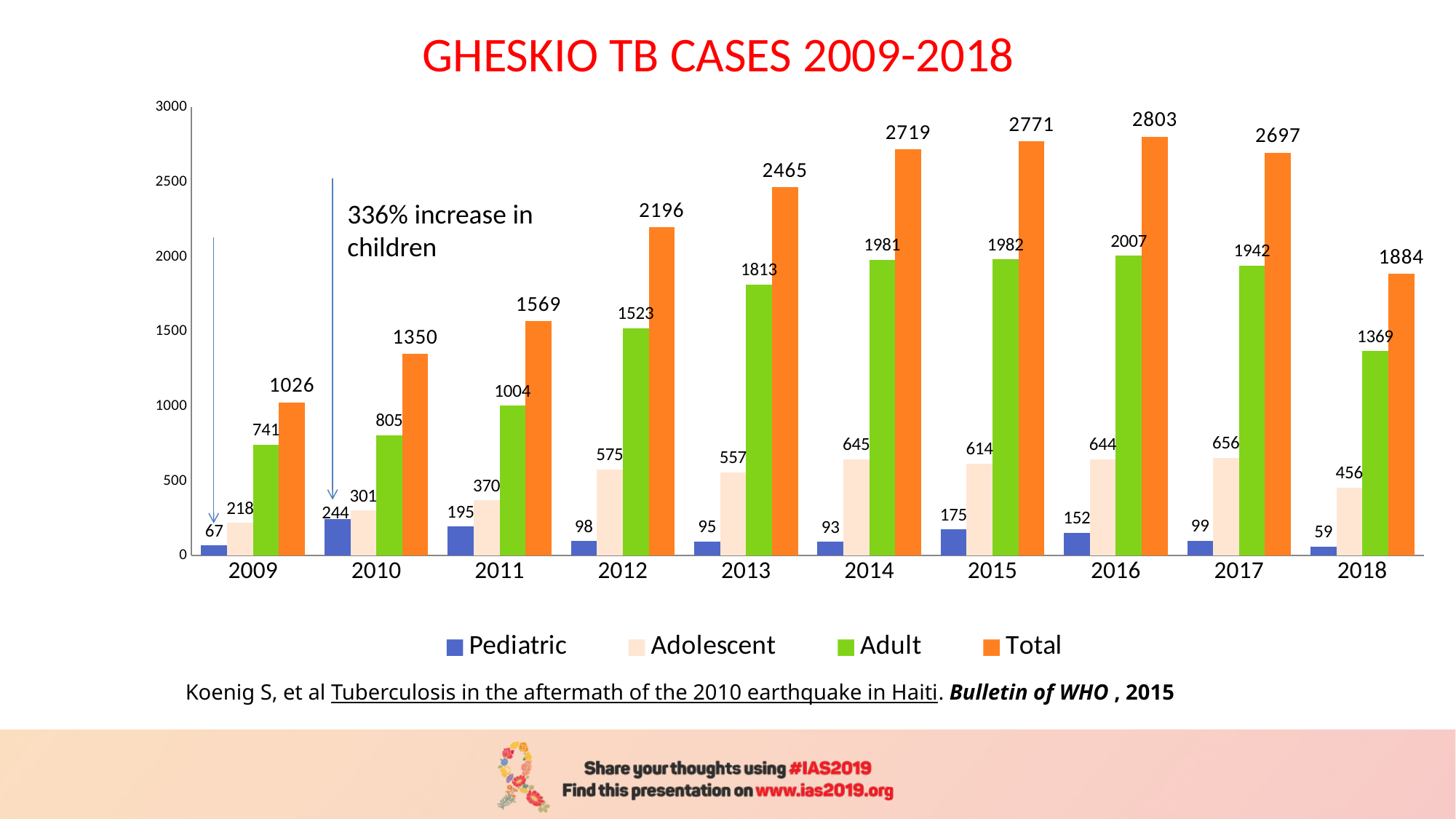
What is the Adult value for 2013? 1813 What is the Adolescent value for 2017? 656 Which is larger, the Adult value for 2015 or the Adult value for 2014? Adult value for 2015 How many years are shown on the x axis? 10 Which year has the highest Total value? 2016 What is the Total value for 2016? 2803 What is the difference between the Total values for 2010 and 2009? 324 What is the title of the chart? GHESKIO TB CASES 2009-2018 What is the Pediatric value for 2010? 244 What kind of chart is shown on the slide? Bar chart How many series does the legend list? 4 Which year has the lowest Pediatric value? 2018